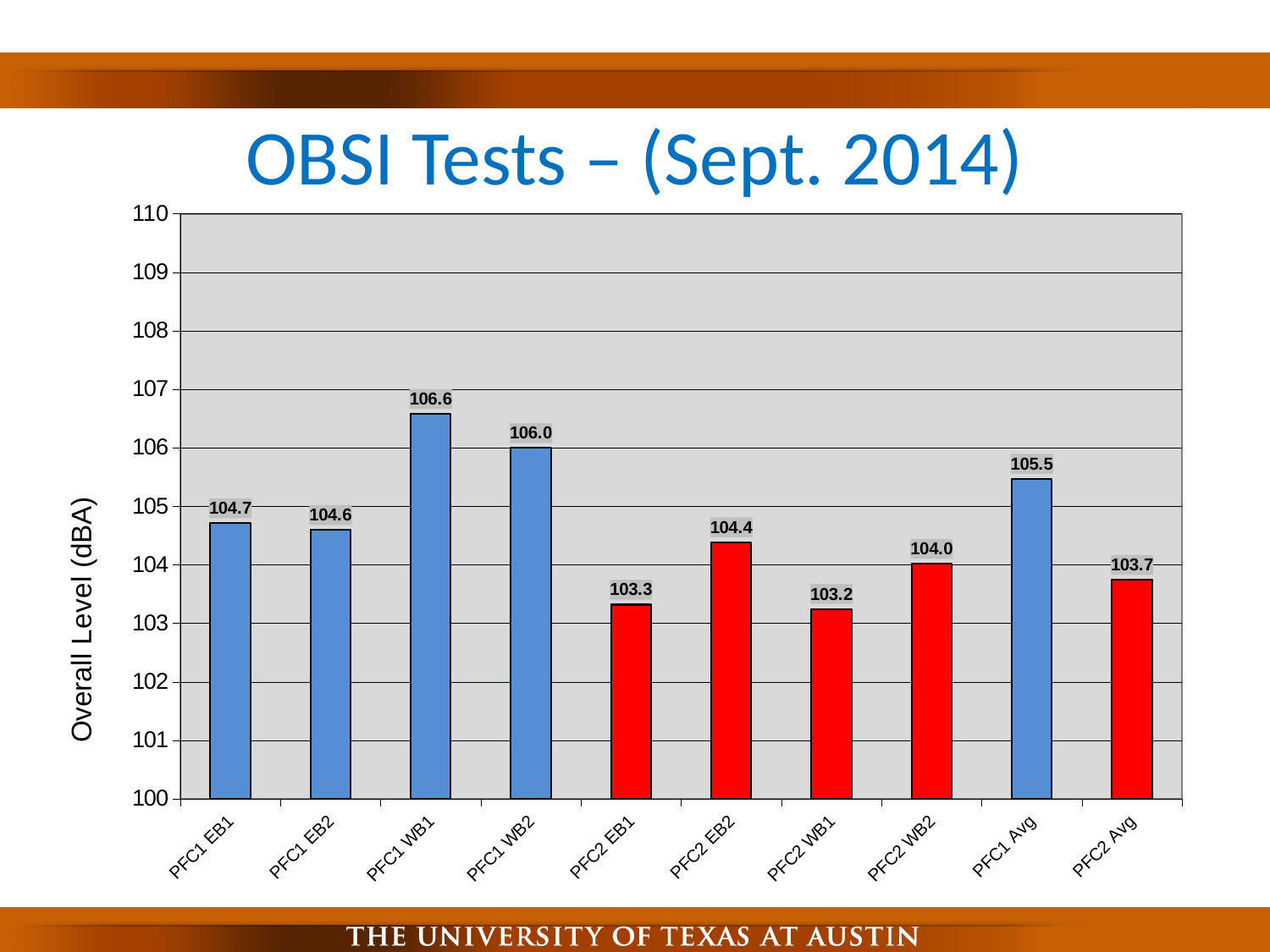
What is the difference between the PFC1 Avg and PFC2 Avg values? 1.8 Is the value for PFC2 EB2 greater or less than 105? less What is the title of the chart? OBSI Tests – (Sept. 2014) Which category has the highest overall level? PFC1 WB1 What is the value shown for PFC1 Avg? 105.5 What is the overall level for PFC1 WB1? 106.6 How many bars are shown in the chart? 10 What is the overall level for PFC2 WB1? 103.2 What type of chart is shown on the slide? bar chart Which is larger, the value for PFC1 EB1 or PFC2 EB1? PFC1 EB1 Which category has the lowest overall level? PFC2 WB1 What is the difference between PFC1 WB1 and PFC1 WB2? 0.6